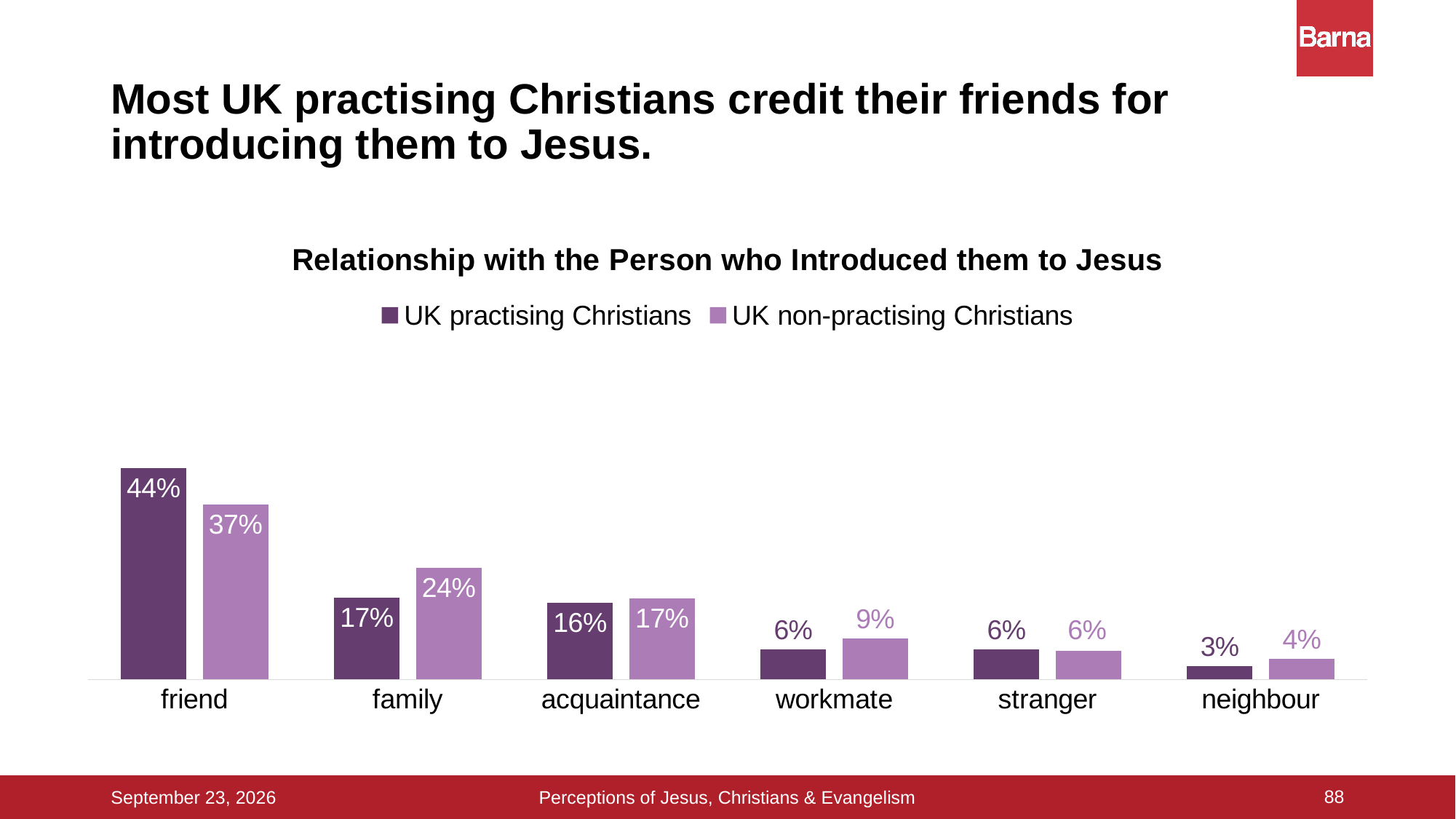
What kind of chart is shown on the slide? bar chart Which category has the highest value for UK practising Christians? friend What is the value for UK non-practising Christians in the workmate category? 9% In the family category, which series has the larger value? UK non-practising Christians How many relationship categories are shown on the x axis? 6 What is the value for UK non-practising Christians in the family category? 24% How many series does the legend list? 2 What is the difference between UK practising Christians and UK non-practising Christians in the friend category? 7% What percentage of UK practising Christians credit a friend for introducing them to Jesus? 44% What is the title of the chart? Relationship with the Person who Introduced them to Jesus Which category has the lowest value for UK non-practising Christians? neighbour What is the value for UK practising Christians in the acquaintance category? 16%